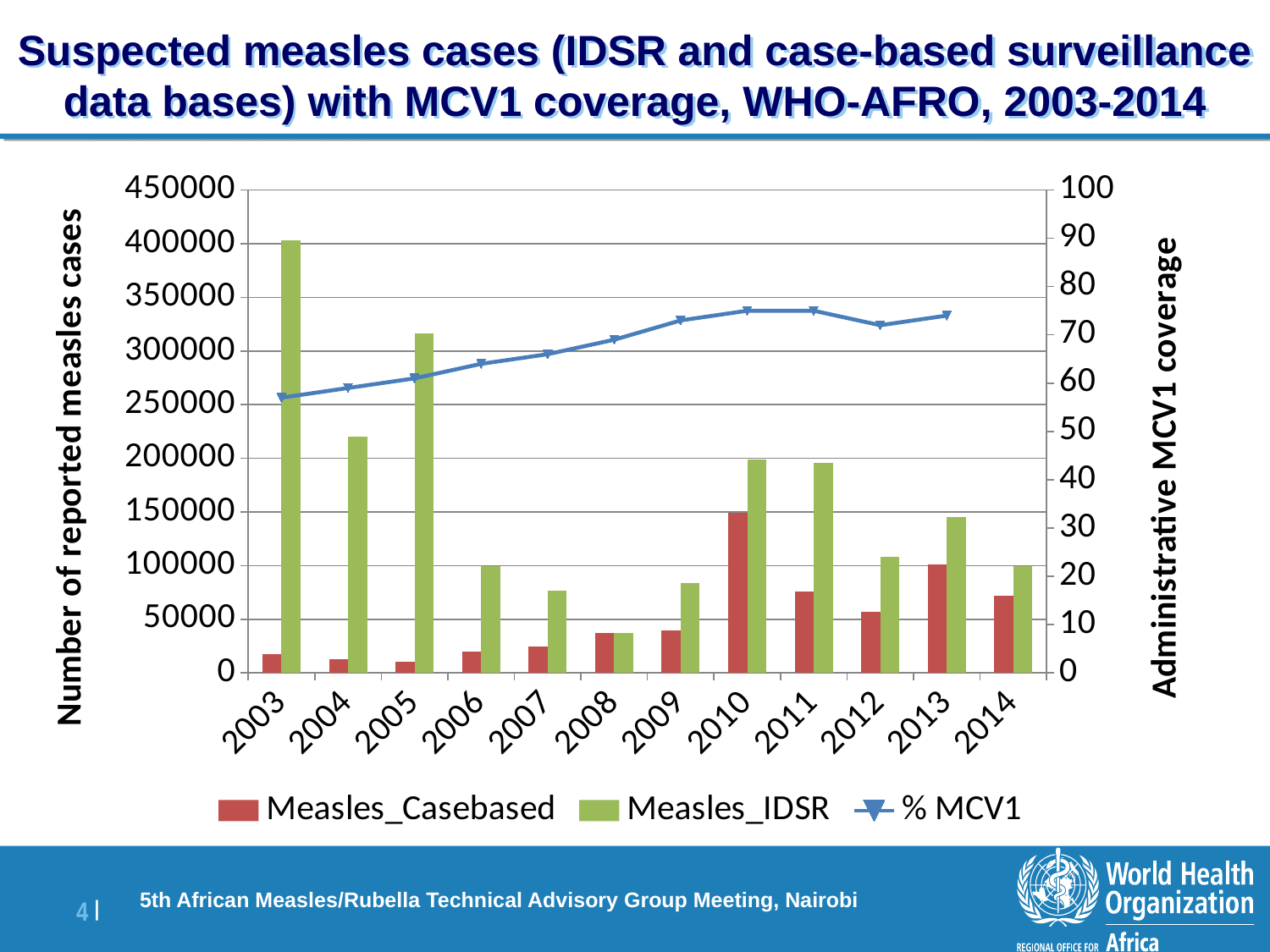
How many series does the legend list? 3 Is the % MCV1 value for 2003 greater or less than 50? greater In which year is the Measles_IDSR value lowest? 2008 What kind of chart is shown on the slide? bar chart with a line In which year is the Measles_Casebased value highest? 2010 What is the label of the right-hand vertical axis? Administrative MCV1 coverage How many years are shown on the x axis? 12 Is the Measles_IDSR value for 2003 greater or less than 350000? greater Does the % MCV1 line rise or fall from 2003 to 2010? rise Which is larger, the Measles_IDSR value for 2004 or for 2005? 2005 In which year is the Measles_IDSR value highest? 2003 Is the Measles_Casebased value for 2010 greater or less than 100000? greater